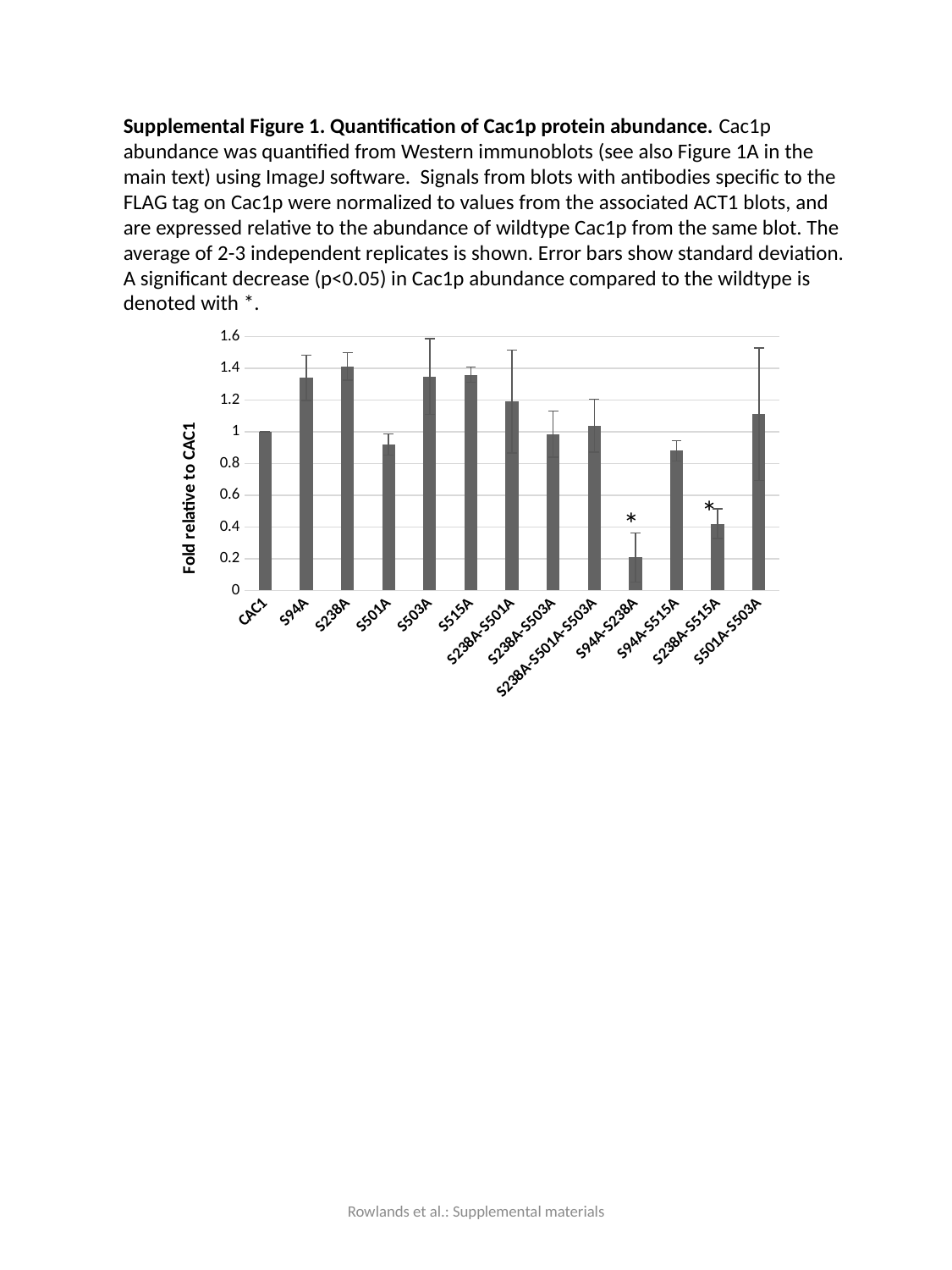
Is the value for S94A-S515A greater or less than 1? less Is the value for S238A-S515A greater or less than 0.6? less How many categories are plotted on the x axis of the chart? 13 Which category has the lowest value in the chart? S94A-S238A Is the value for S94A greater or less than 1.2? greater What is the title of the y axis of the chart? Fold relative to CAC1 Which is larger, the value for S94A-S238A or the value for S238A-S515A? S238A-S515A What is the value for CAC1 in the chart? 1 Which is larger, the value for S238A or the value for S501A? S238A What kind of chart is shown on the slide? bar chart